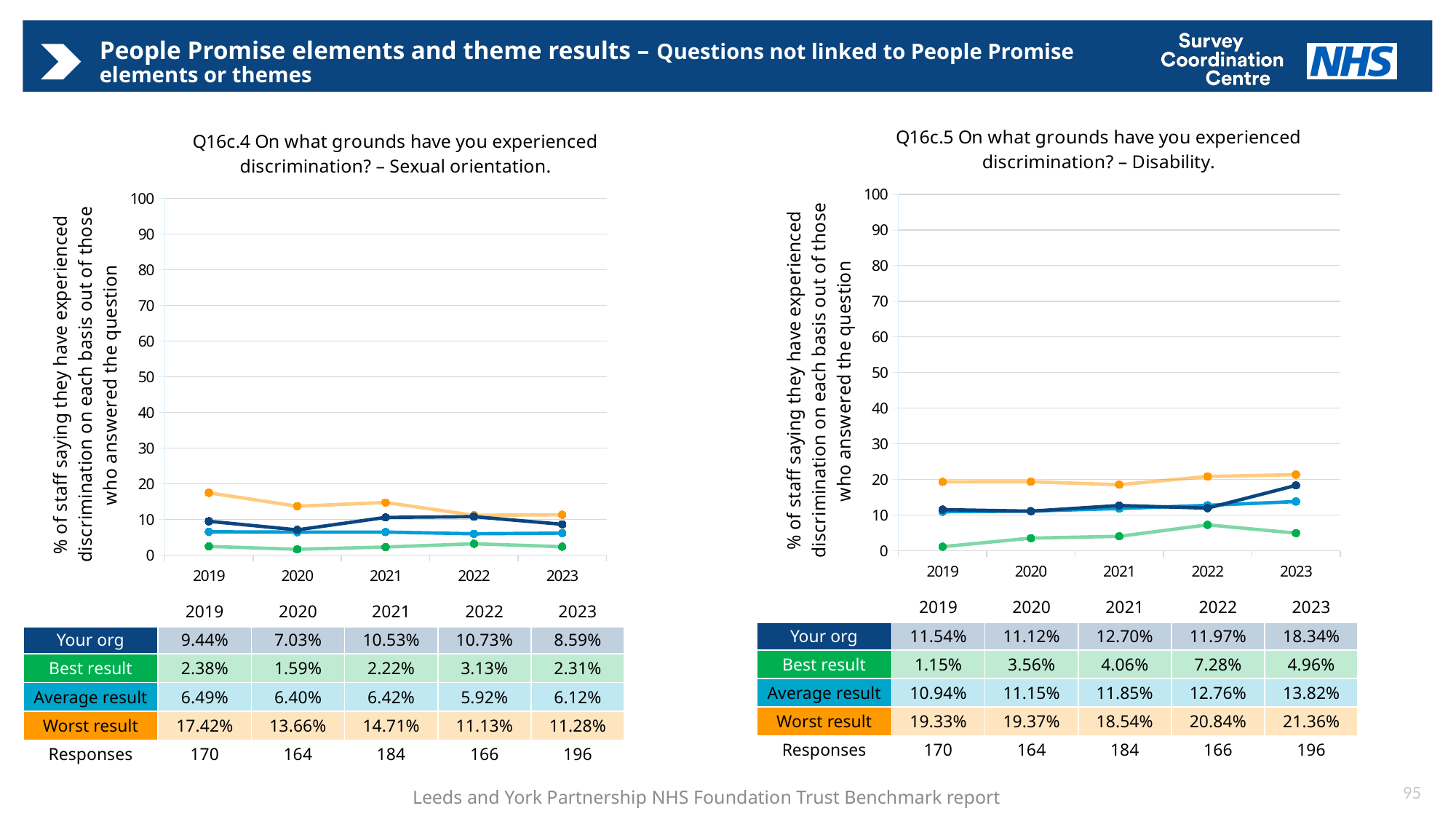
In the Q16c.5 Disability chart, which year has the lowest Best result value? 2019 In the Q16c.4 Sexual orientation chart, how many responses were recorded in 2023? 196 What type of chart is the Q16c.4 Sexual orientation chart? line chart In the Q16c.4 Sexual orientation chart, is the Your org value for 2022 larger or smaller than the Your org value for 2020? larger In the Q16c.5 Disability chart, what is the difference between the Your org value and the Average result value in 2023? 4.52% How many series are shown in the Q16c.5 Disability chart? 4 In the Q16c.4 Sexual orientation chart, which year has the highest Worst result value? 2019 In the Q16c.5 Disability chart, what is the Worst result value for 2023? 21.36% In the Q16c.5 Disability chart, does the Average result rise or fall from 2019 to 2023? rise In the Q16c.4 Sexual orientation chart, what is the Your org value for 2021? 10.53% How many years are plotted on the x axis of the Q16c.4 Sexual orientation chart? 5 In the Q16c.5 Disability chart, is the Worst result value for 2022 greater or less than 30? less